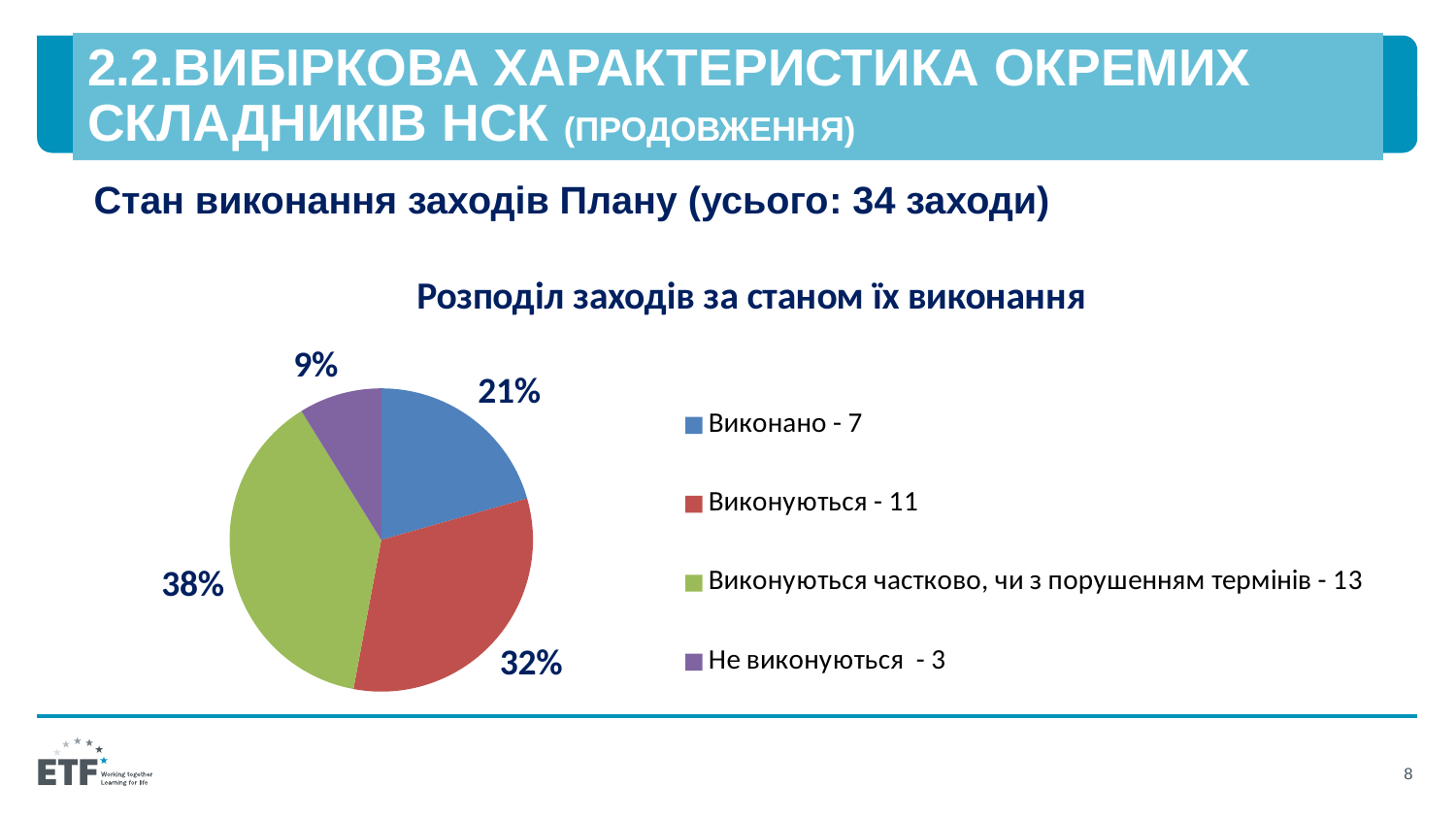
What percentage share does the slice for "Не виконуються - 3" have? 9% How many slices does the pie chart have? 4 What percentage share does the slice for "Виконано - 7" have? 21% What percentage share does the slice for "Виконуються частково, чи з порушенням термінів - 13" have? 38% What is the title of the chart? Розподіл заходів за станом їх виконання Which category has the largest share of the pie? Виконуються частково, чи з порушенням термінів - 13 What colour is the slice for "Виконано - 7"? Blue What kind of chart is shown on the slide? Pie chart Which is larger: the share for "Виконано - 7" or the share for "Виконуються - 11"? Виконуються - 11 Which category has the smallest share of the pie? Не виконуються - 3 What is the difference in percentage points between the "Виконуються частково, чи з порушенням термінів - 13" slice and the "Не виконуються - 3" slice? 29 percentage points